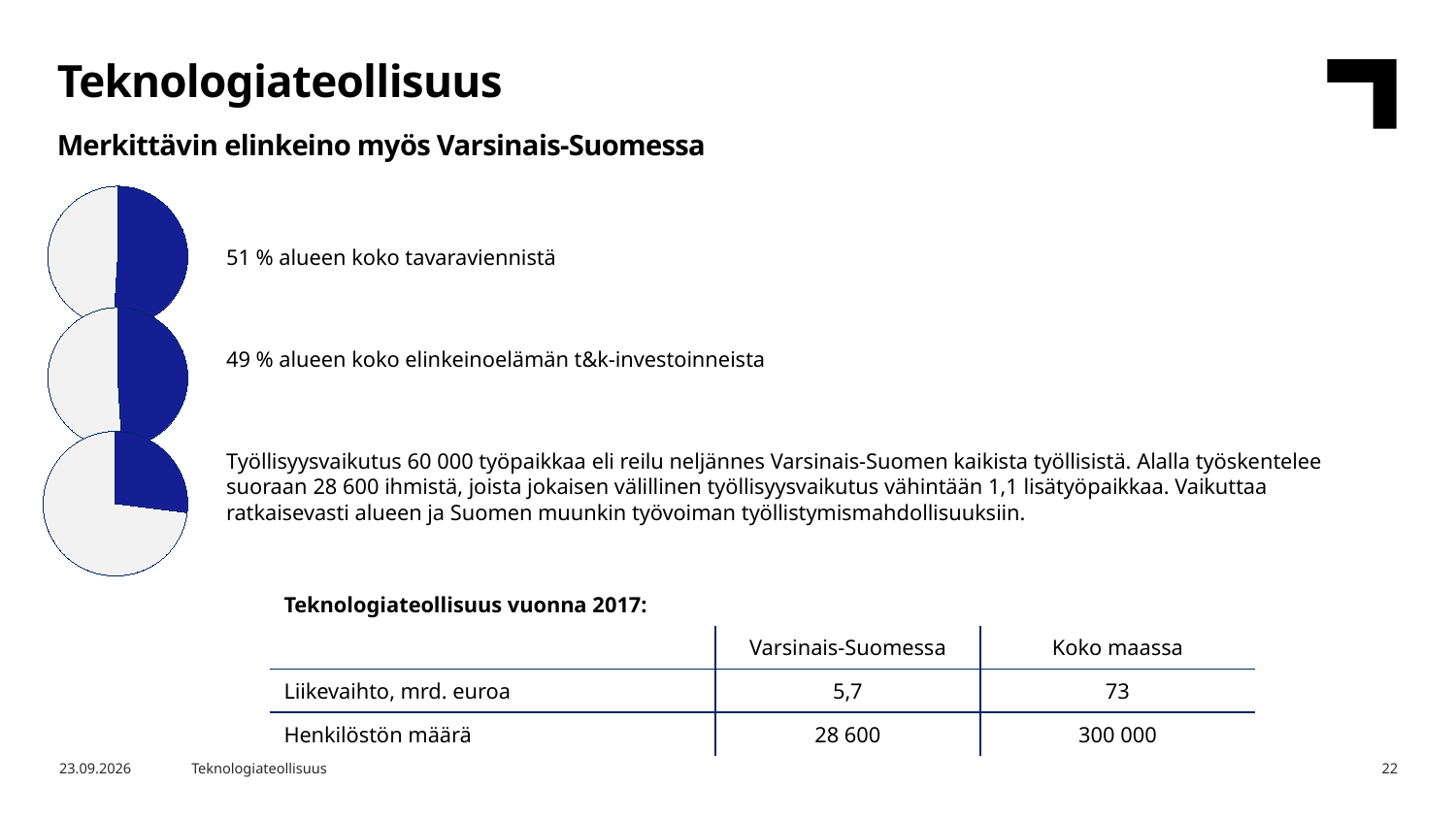
What colour is the highlighted slice in each of the three pie charts? blue In the top pie chart, what share of the region's total goods exports does the blue slice represent, according to the text beside it? 51 % How many slices does the bottom pie chart have? 2 Which pie chart has the smaller blue slice: the top pie chart or the bottom pie chart? the bottom pie chart What text accompanies the top pie chart? 51 % alueen koko tavaraviennistä What kind of chart is the top chart on the left of the slide? pie chart In the middle pie chart, what share of the region's business R&D investments does the blue slice represent, according to the text beside it? 49 % Is the blue slice in the top pie chart larger or smaller than the blue slice in the bottom pie chart? larger Is the blue slice in the bottom pie chart larger or smaller than half of the pie? smaller How many pie charts are shown on the left side of the slide? 3